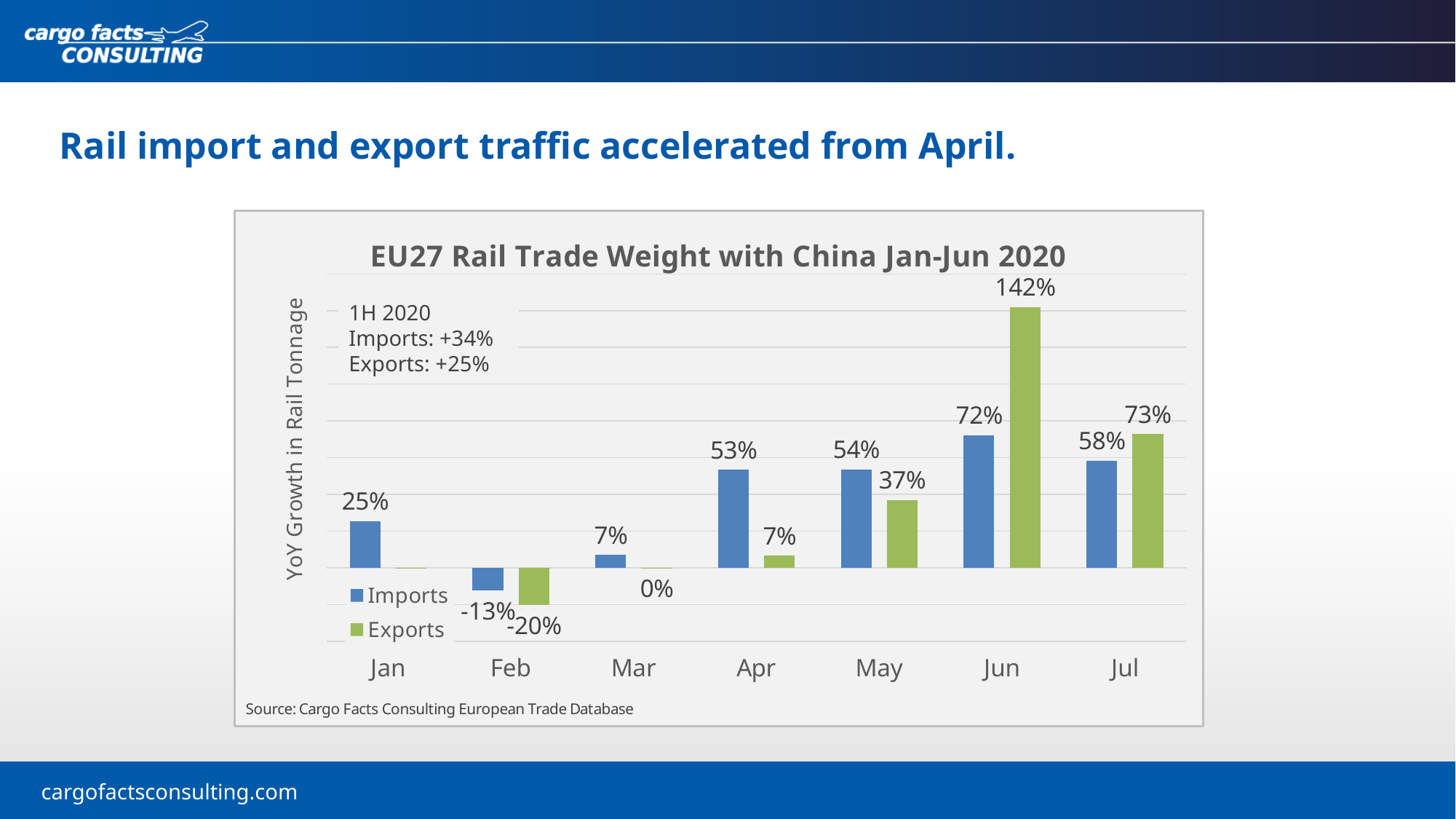
What type of chart is shown on the slide? Bar chart In Jul, which is larger, Imports or Exports? Exports What is the difference between the Exports and Imports values for Jun? 70 percentage points How many months are shown on the x axis? 7 What is the Imports value for Feb? -13% What is the Exports value for Jun? 142% Which month has the lowest Exports value? Feb How many series does the legend list? 2 Which month has the highest Imports value? Jun Which month has the highest Exports value? Jun What is the Imports value for Jun? 72% What is the Exports value for May? 37%